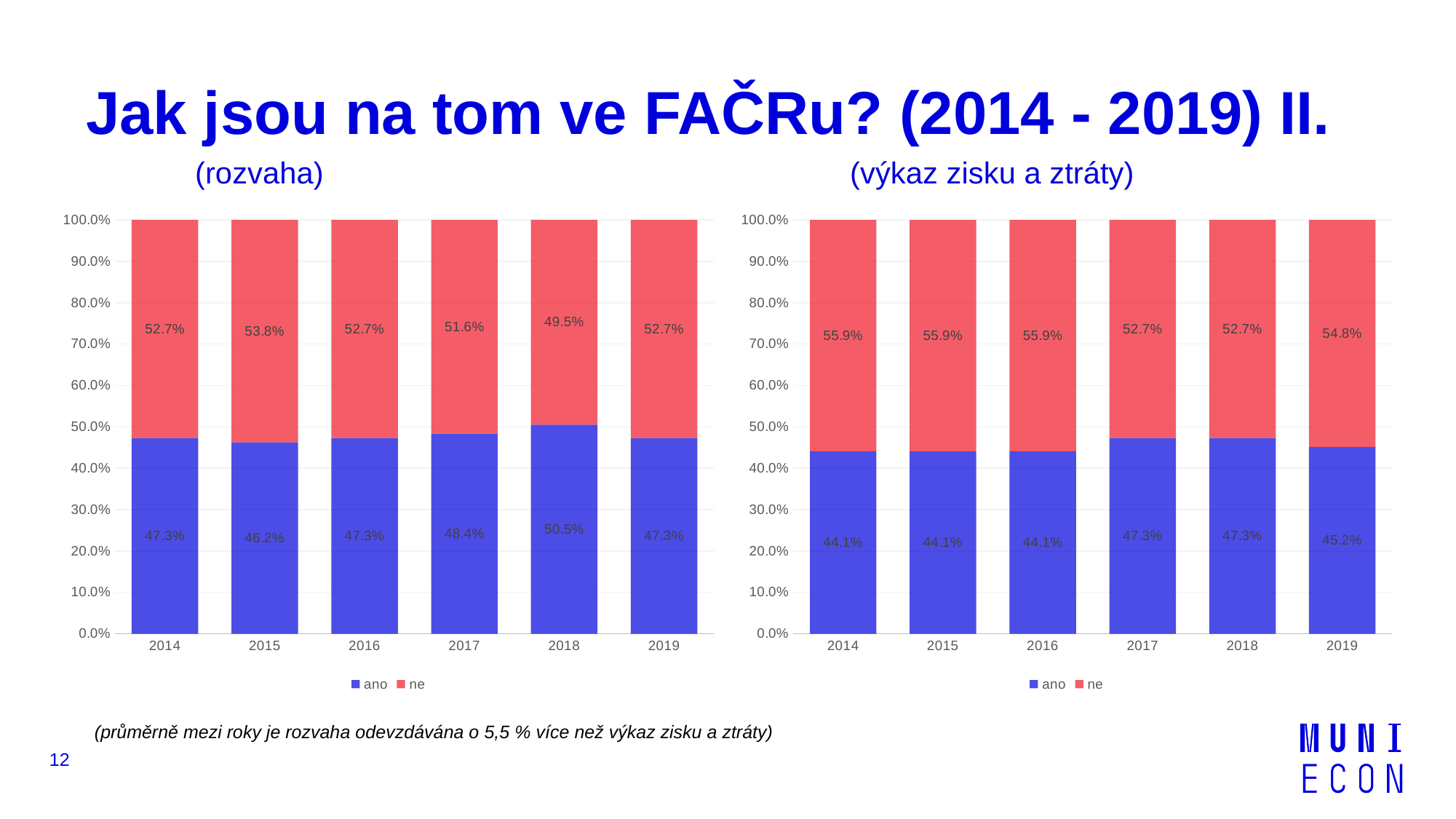
In the left chart (rozvaha), what is the total of the stacked bar for 2016? 100.0% In the right chart (výkaz zisku a ztráty), is the "ano" value for 2014 greater or less than 50.0%? less In the left chart (rozvaha), which year has the lowest "ano" value? 2015 How many years are shown on the x axis of the left chart (rozvaha)? 6 What kind of chart is the left chart (rozvaha)? stacked bar chart In the left chart (rozvaha), which is larger: the "ano" value in 2017 or the "ano" value in 2015? 2017 In the left chart (rozvaha), what is the value for "ano" in 2018? 50.5% In the right chart (výkaz zisku a ztráty), what is the difference between the "ne" value in 2014 and the "ne" value in 2017? 3.2% In the right chart (výkaz zisku a ztráty), what is the value for "ne" in 2019? 54.8% In the left chart (rozvaha), which year has the highest "ano" value? 2018 What colour represents the "ne" series in both charts? red How many series does the legend of the right chart (výkaz zisku a ztráty) list? 2